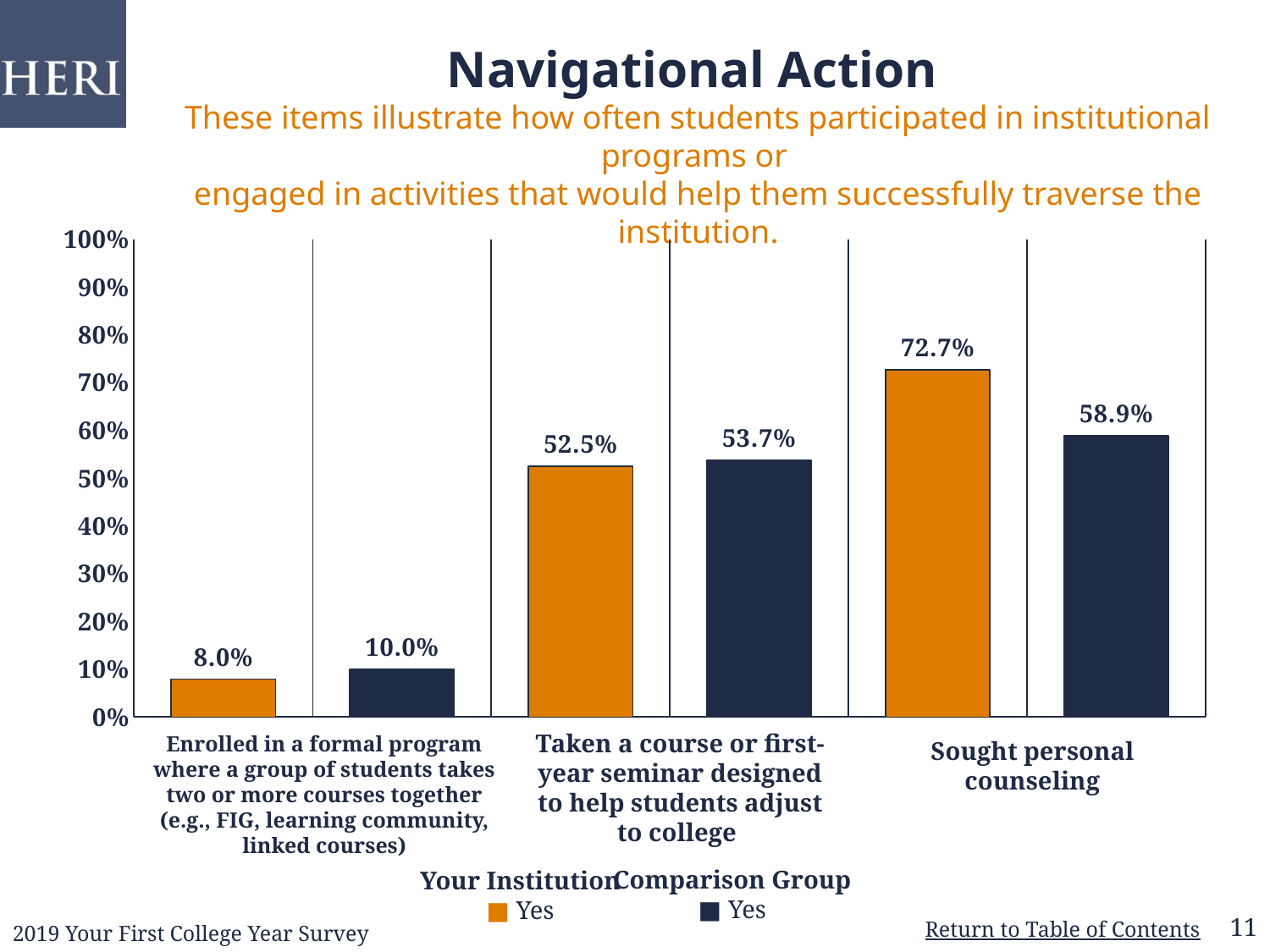
How many series does the chart's legend list? 2 What is the difference between Your Institution and the Comparison Group for 'Sought personal counseling'? 13.8% Is the Comparison Group value for 'Sought personal counseling' greater or less than 50%? greater What is the Your Institution value for 'Enrolled in a formal program where a group of students takes two or more courses together'? 8.0% Which category has the lowest value for the Comparison Group? Enrolled in a formal program where a group of students takes two or more courses together What kind of chart is shown on the slide? Bar chart What colour are the bars for Your Institution? Orange Which category has the highest value for Your Institution? Sought personal counseling What is the Comparison Group value for 'Taken a course or first-year seminar designed to help students adjust to college'? 53.7% For 'Enrolled in a formal program where a group of students takes two or more courses together', which is larger: Your Institution or the Comparison Group? Comparison Group What percentage of students at Your Institution sought personal counseling? 72.7% How many categories are shown on the x axis of the chart? 3